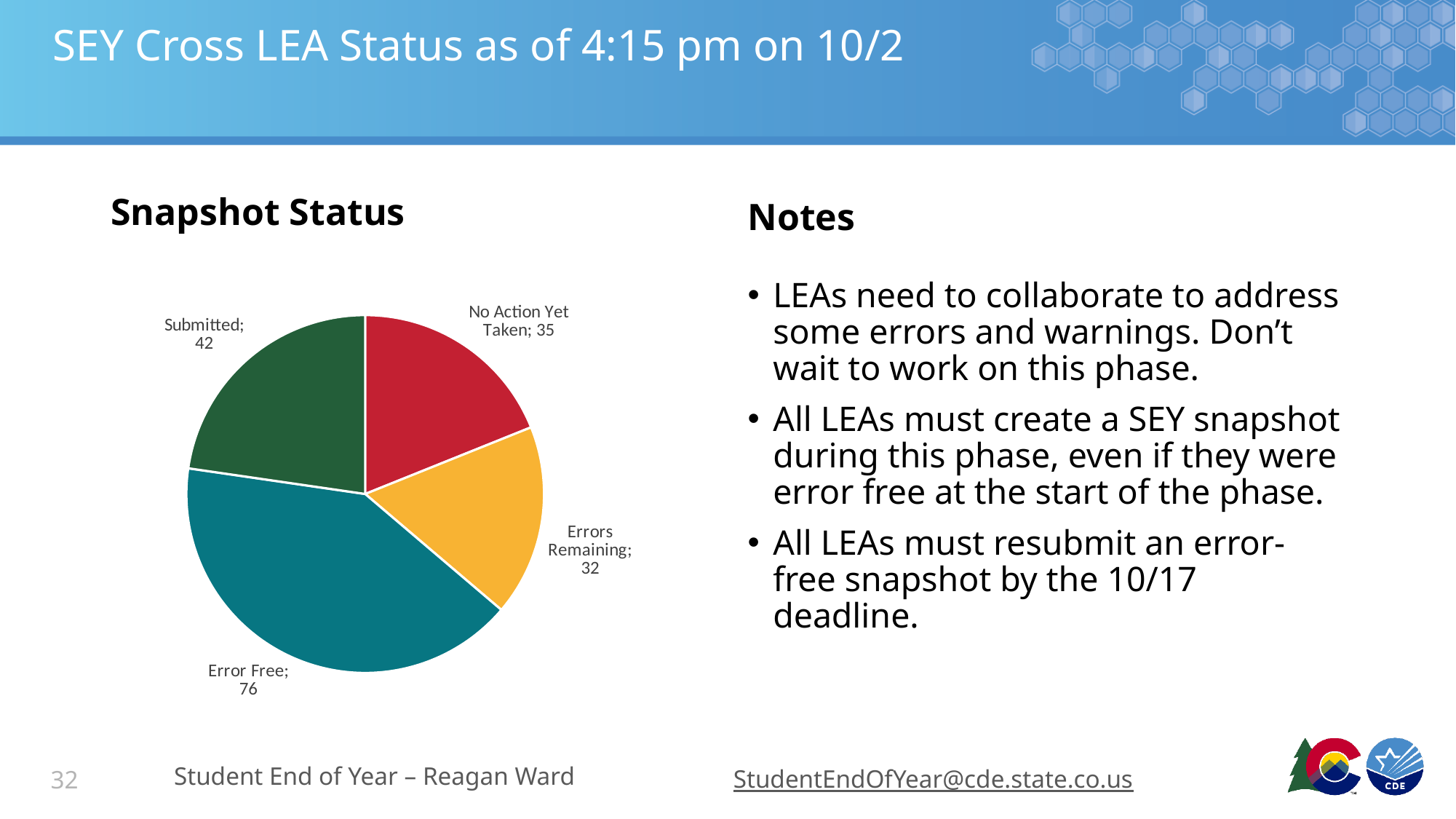
What is the difference between the Error Free and Submitted values in the Snapshot Status pie chart? 34 What colour is the Error Free slice in the Snapshot Status pie chart? Teal What is the value for Error Free in the Snapshot Status pie chart? 76 What is the value for Submitted in the Snapshot Status pie chart? 42 What is the total of all slices in the Snapshot Status pie chart? 185 What type of chart is shown under "Snapshot Status"? Pie chart Which category has the smallest slice in the Snapshot Status pie chart? Errors Remaining Which category has the largest slice in the Snapshot Status pie chart? Error Free How many categories are shown in the Snapshot Status pie chart? 4 Which is larger in the Snapshot Status pie chart, Submitted or No Action Yet Taken? Submitted What is the value for Errors Remaining in the Snapshot Status pie chart? 32 What is the value for No Action Yet Taken in the Snapshot Status pie chart? 35